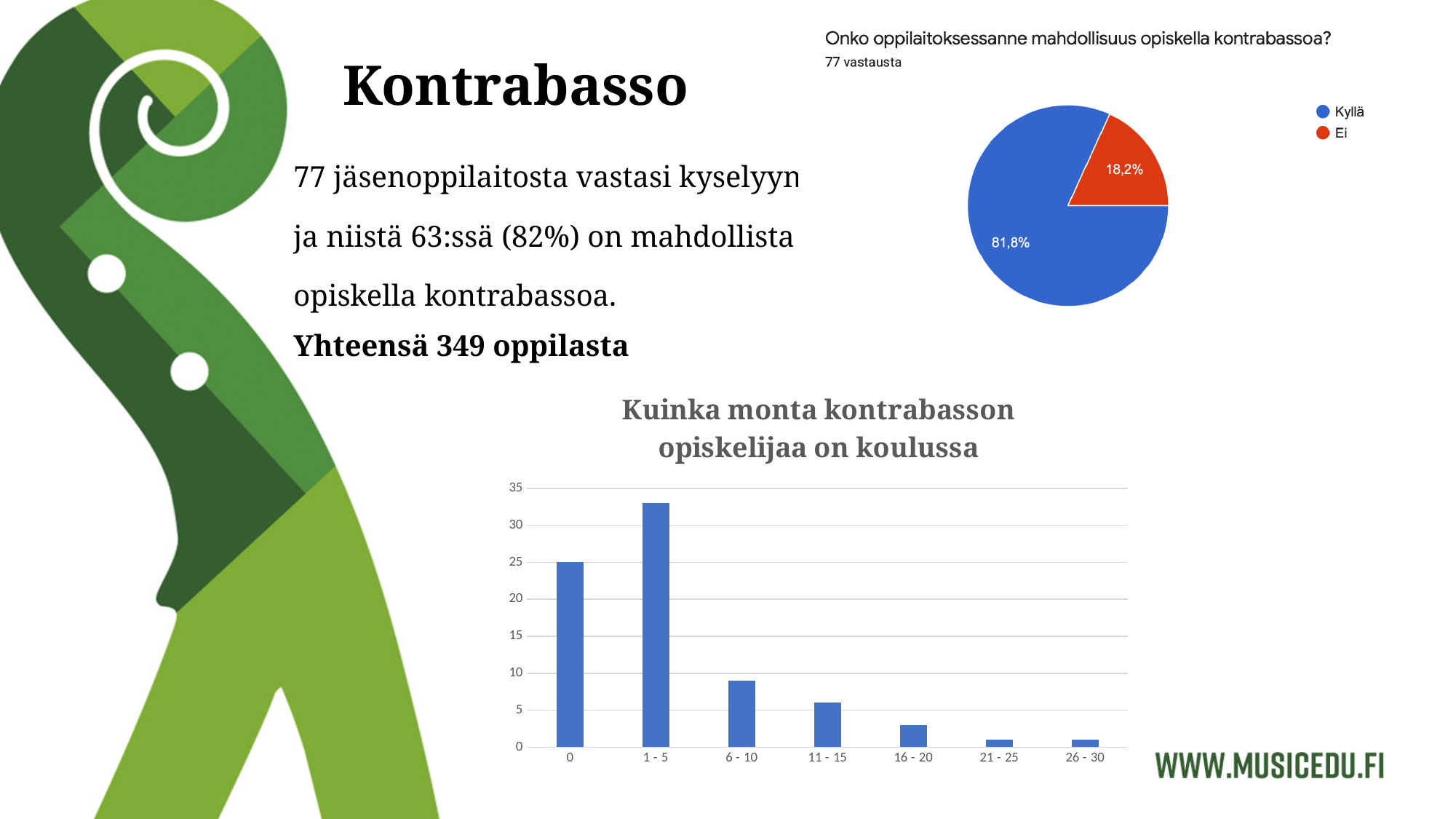
In the pie chart 'Onko oppilaitoksessanne mahdollisuus opiskella kontrabassoa?', what colour is the 'Ei' slice? Red In the bar chart 'Kuinka monta kontrabasson opiskelijaa on koulussa', is the value for '6 - 10' greater or less than 10? less In the bar chart 'Kuinka monta kontrabasson opiskelijaa on koulussa', how many categories are shown on the x axis? 7 In the pie chart 'Onko oppilaitoksessanne mahdollisuus opiskella kontrabassoa?', how many slices does the legend list? 2 In the pie chart 'Onko oppilaitoksessanne mahdollisuus opiskella kontrabassoa?', what share of responses is 'Ei'? 18,2% In the bar chart 'Kuinka monta kontrabasson opiskelijaa on koulussa', which category has the highest bar? 1 - 5 In the pie chart 'Onko oppilaitoksessanne mahdollisuus opiskella kontrabassoa?', which slice is larger, 'Kyllä' or 'Ei'? Kyllä In the bar chart 'Kuinka monta kontrabasson opiskelijaa on koulussa', which bar is taller, '0' or '6 - 10'? 0 In the bar chart 'Kuinka monta kontrabasson opiskelijaa on koulussa', do the values rise or fall from '1 - 5' to '26 - 30'? Fall What kind of chart is 'Kuinka monta kontrabasson opiskelijaa on koulussa'? Bar chart In the bar chart 'Kuinka monta kontrabasson opiskelijaa on koulussa', is the value for '1 - 5' greater or less than 30? greater In the pie chart 'Onko oppilaitoksessanne mahdollisuus opiskella kontrabassoa?', what share of responses is 'Kyllä'? 81,8%